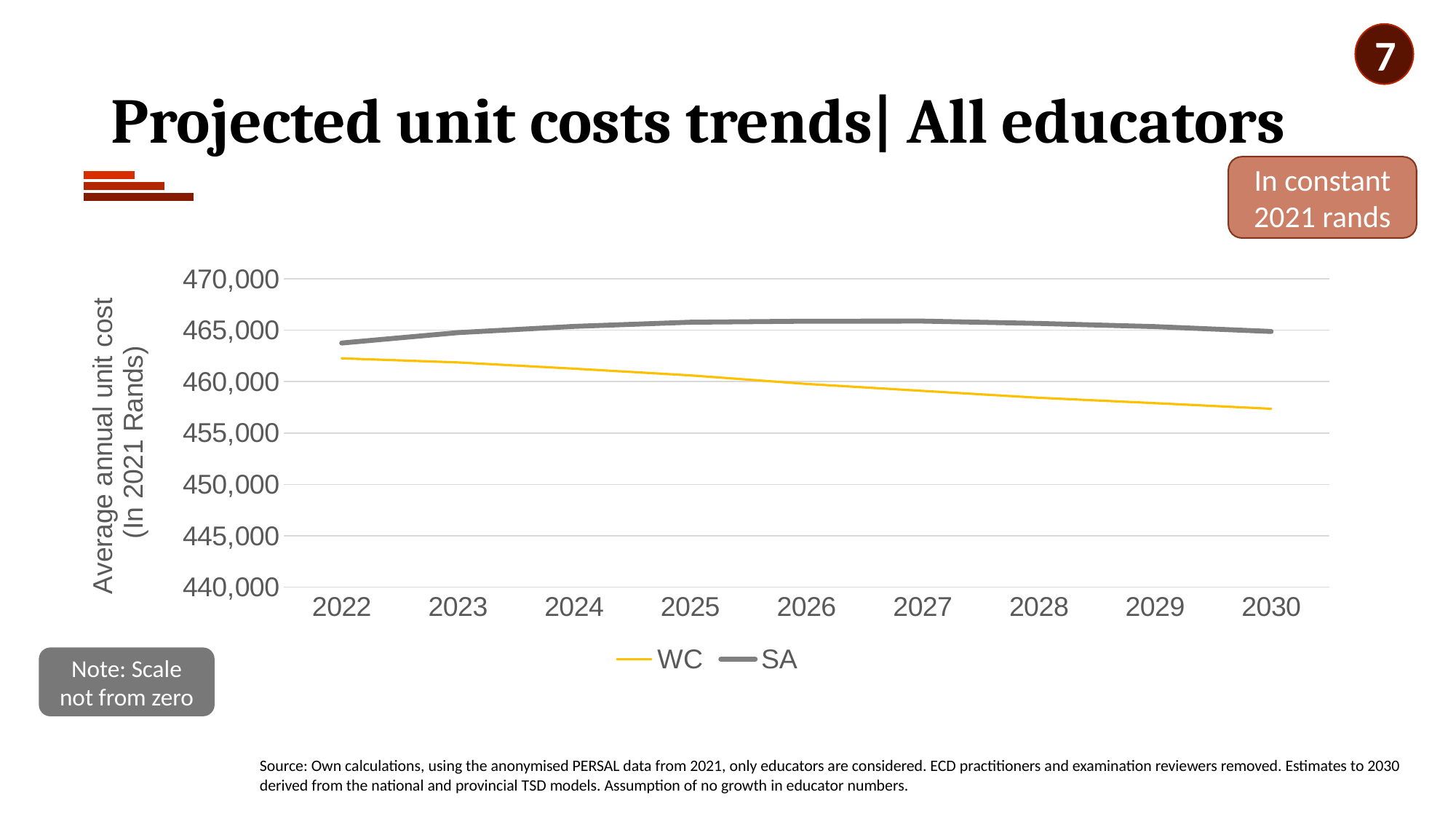
Is the value for SA in 2022 greater or less than 465,000? less What is the title of the chart's vertical axis? Average annual unit cost (In 2021 Rands) How many years are shown on the x axis? 9 What kind of chart is shown on the slide? Line chart Which series are listed in the legend? WC and SA In which year is the WC value lowest? 2030 Does the WC line rise or fall from 2022 to 2030? Fall In which year is the WC value highest? 2022 Is the value for WC in 2030 greater or less than 460,000? less In 2030, which series has the higher value, WC or SA? SA In 2022, which series has the higher value, WC or SA? SA How many series does the legend list? 2